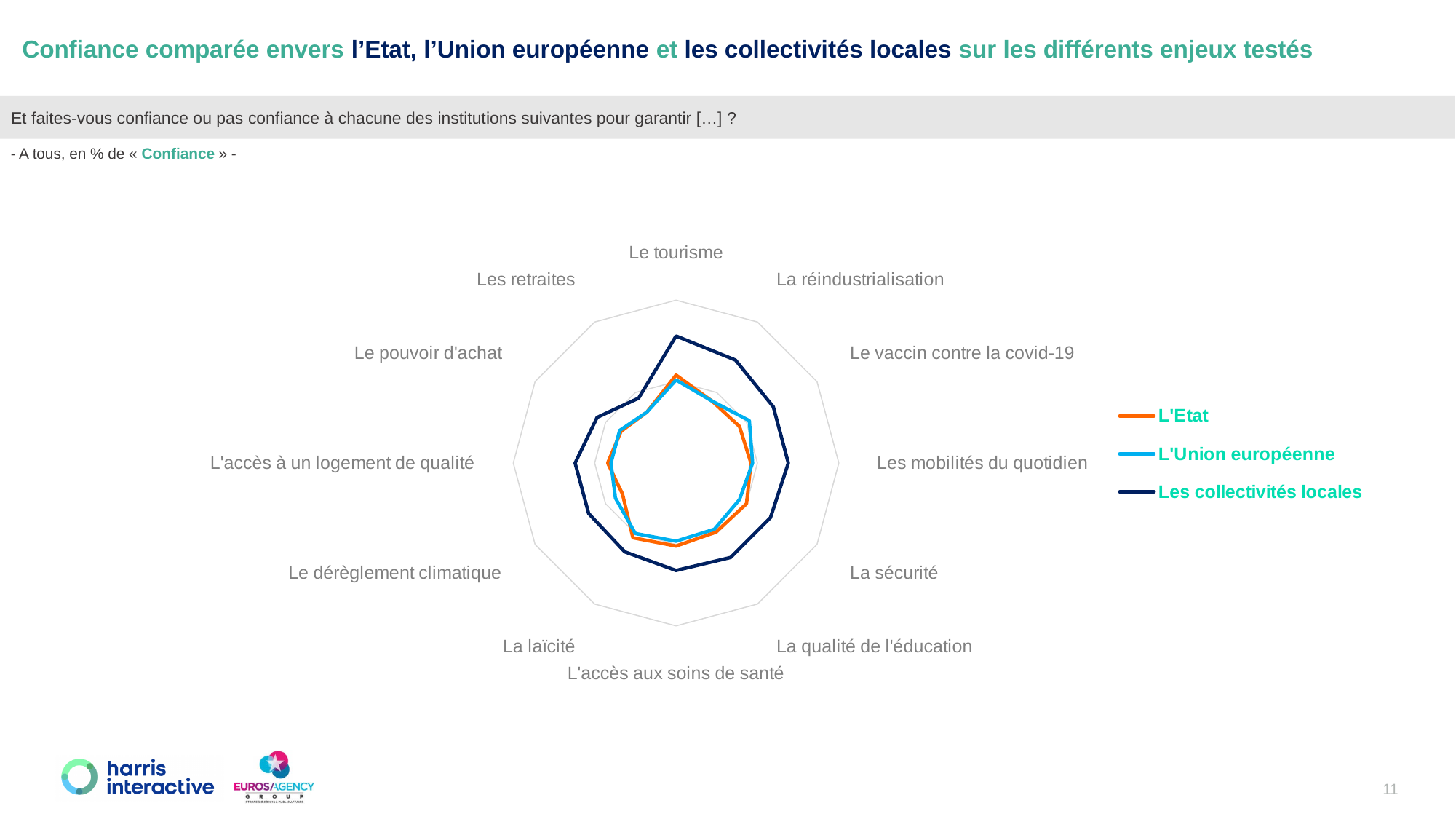
What kind of chart is shown on the slide? Radar chart How many categories (enjeux) are plotted around the radar chart? 12 For which category does Les collectivités locales reach its highest value? Le tourisme What colour is the line for Les collectivités locales? Dark navy blue Which series has the highest values across the categories overall? Les collectivités locales How many series does the legend list? 3 Which series does the legend list first? L'Etat For La sécurité, which is larger: the value for L'Union européenne or for Les collectivités locales? Les collectivités locales For La réindustrialisation, which is larger: the value for L'Etat or for Les collectivités locales? Les collectivités locales For Le tourisme, which is larger: the value for L'Etat or for Les collectivités locales? Les collectivités locales